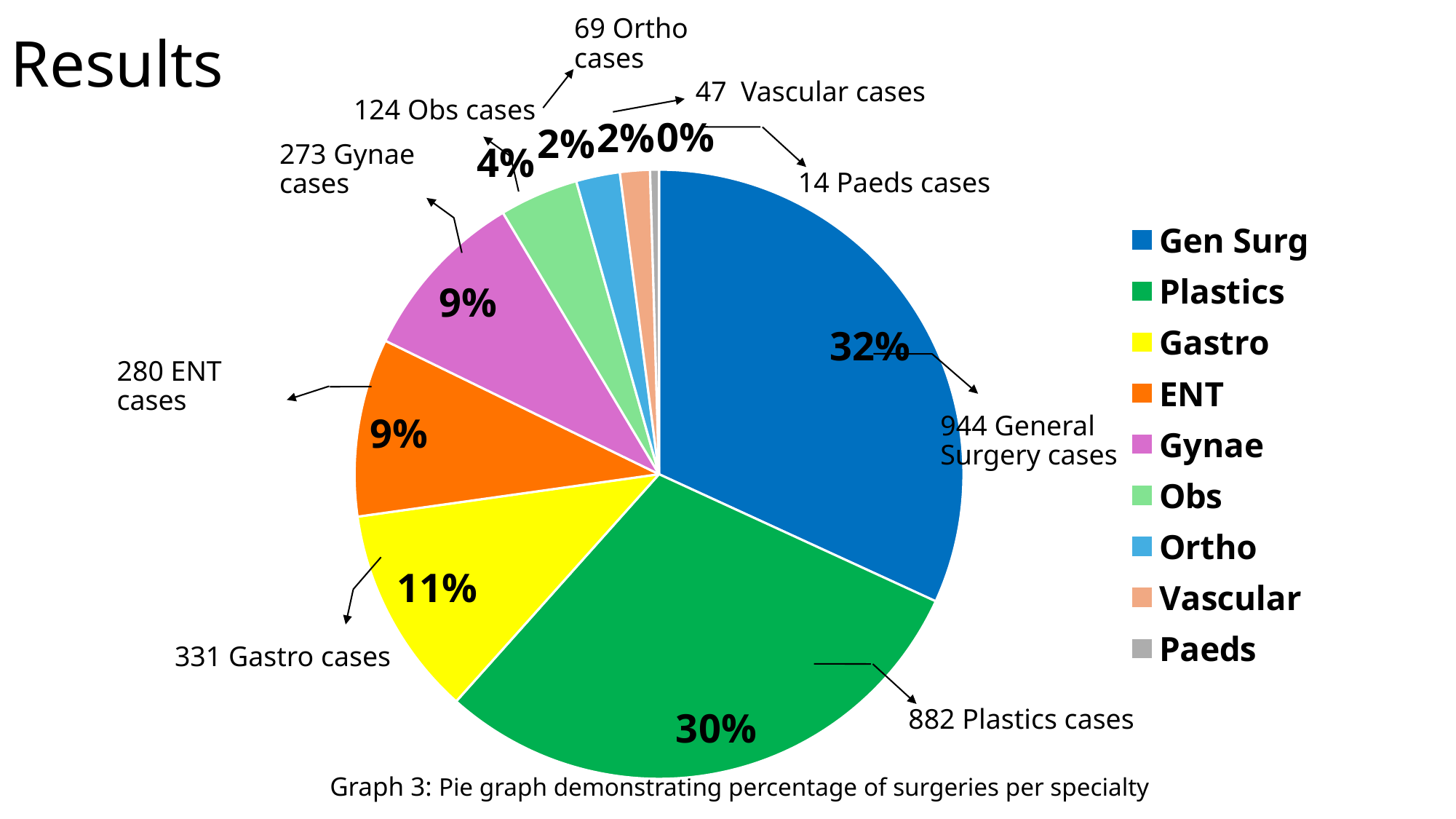
How many specialties does the legend list? 9 How many General Surgery cases are shown on the chart? 944 Which specialty has the largest share of surgeries? Gen Surg What percentage of surgeries does the Obs slice represent? 4% How many Paeds cases are shown on the chart? 14 What percentage of surgeries does the Gen Surg slice represent? 32% What percentage of surgeries does the Plastics slice represent? 30% Which has more cases, ENT or Gynae? ENT How many Plastics cases are shown on the chart? 882 Which specialty has the smallest share of surgeries? Paeds How many more General Surgery cases are there than Plastics cases? 62